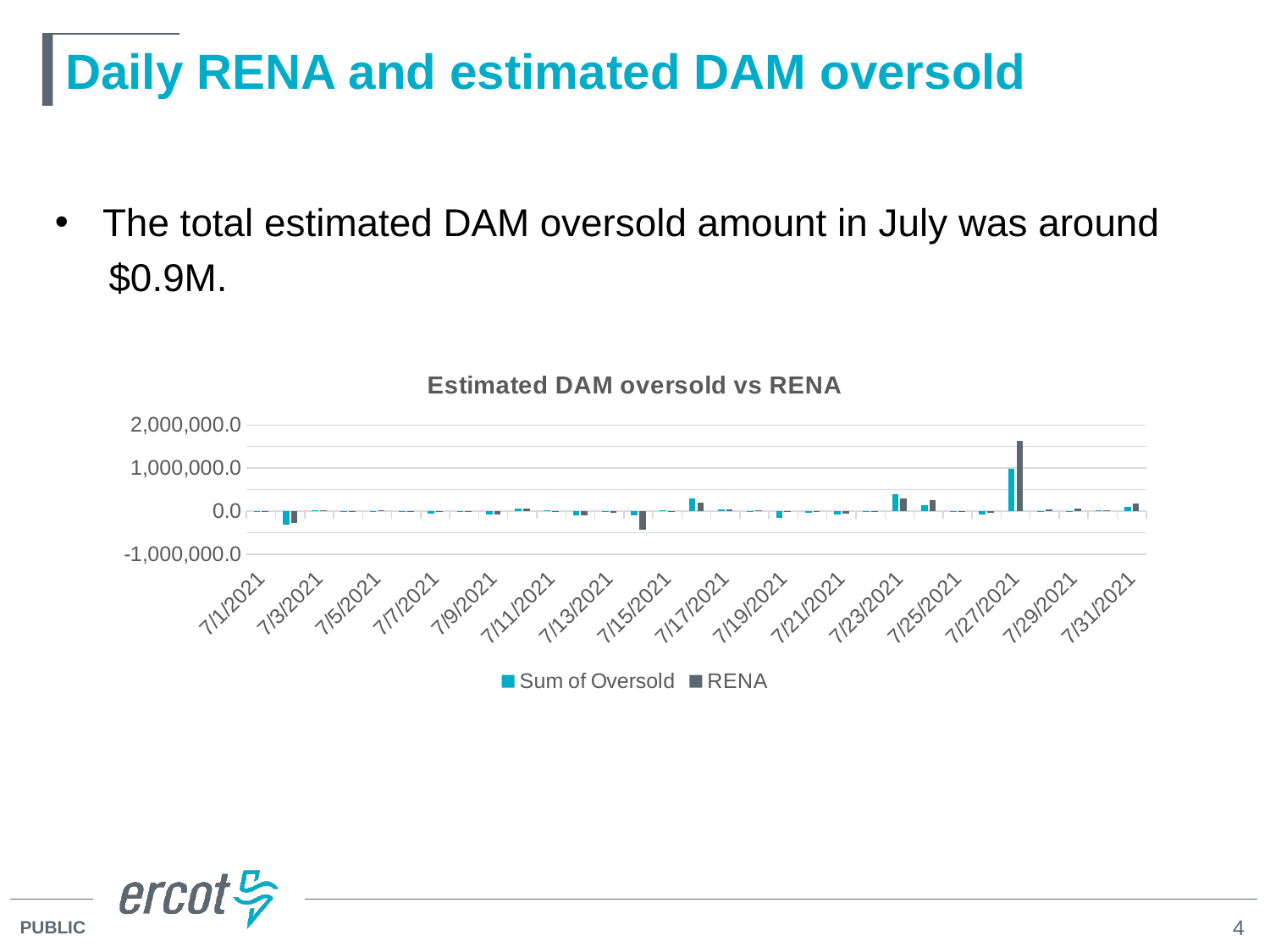
How many date labels are shown along the x axis? 16 Is the Sum of Oversold value for 7/27/2021 greater or less than 0.0? greater On which date does the RENA series reach its highest value? 7/27/2021 What are the two series named in the chart legend? Sum of Oversold and RENA Is the RENA value for 7/27/2021 greater or less than 1,000,000.0? greater What is the highest value shown on the y axis? 2,000,000.0 What type of chart is shown on the slide? bar chart On 7/27/2021, which series has the larger value, Sum of Oversold or RENA? RENA How many series does the chart legend list? 2 What is the title of the chart? Estimated DAM oversold vs RENA